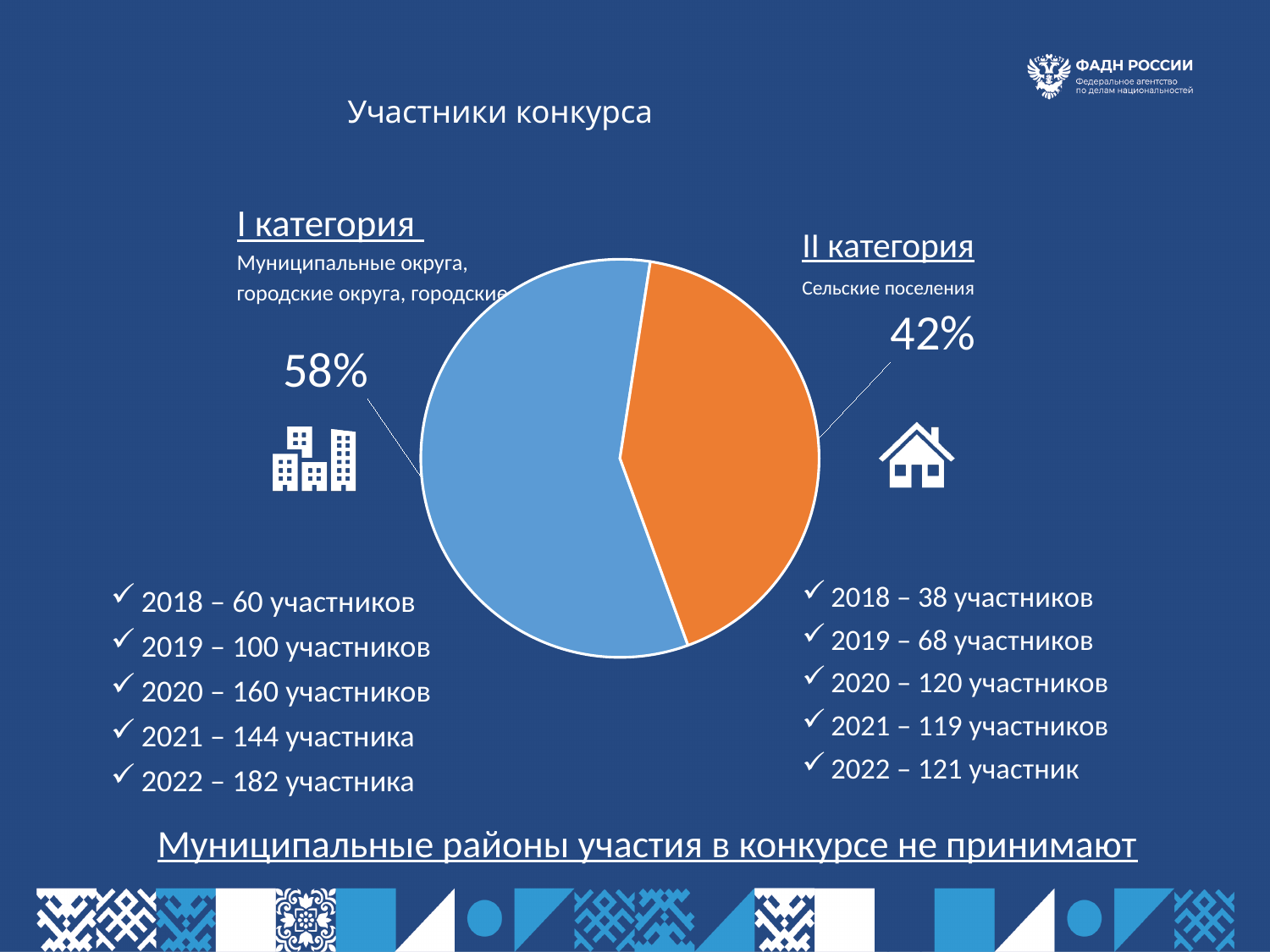
How many slices does the pie chart have? 2 Which category has the largest slice of the pie? I категория What colour is the slice for "II категория" (Сельские поселения)? orange Which category has the smallest slice of the pie? II категория What colour is the slice for "I категория"? blue What share of the pie does "I категория" (Муниципальные округа, городские округа) have? 58% Is the share for "II категория" greater or less than 50%? less What share of the pie does "II категория" (Сельские поселения) have? 42% By how many percentage points does the "I категория" share exceed the "II категория" share? 16 What kind of chart is shown on the slide? pie chart Which category has the larger slice of the pie, "I категория" or "II категория"? I категория